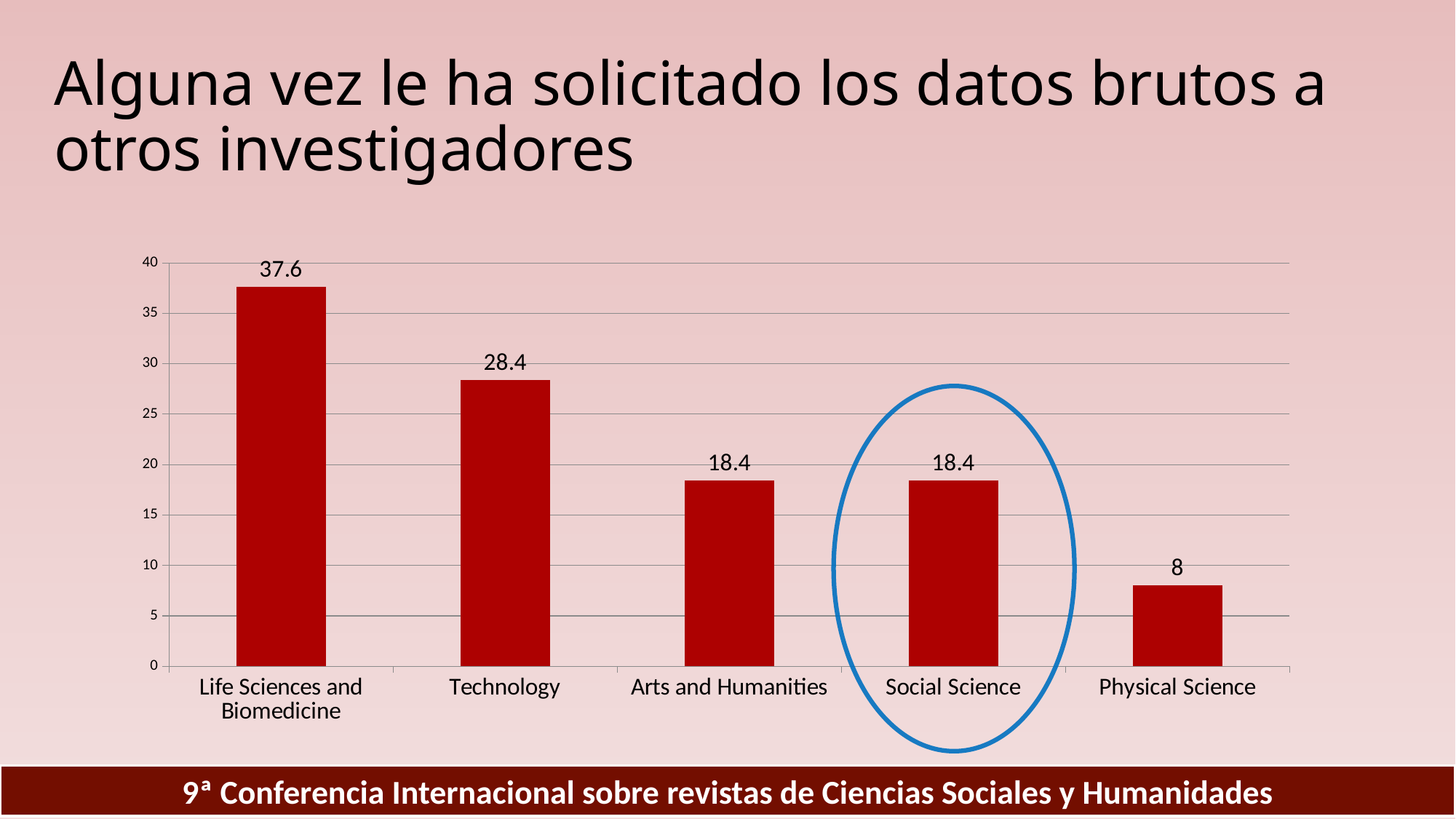
Which category has the lowest value? Physical Science What is the value for Technology? 28.4 What kind of chart is shown on the slide? Bar chart How many categories are shown on the x axis? 5 Which is larger, the value for Technology or the value for Arts and Humanities? Technology Which category has the highest value? Life Sciences and Biomedicine Which category is circled in blue on the chart? Social Science What is the value for Physical Science? 8 What is the value for Life Sciences and Biomedicine? 37.6 What is the difference between the values for Social Science and Physical Science? 10.4 What is the difference between the values for Life Sciences and Biomedicine and Technology? 9.2 What is the value for Social Science? 18.4